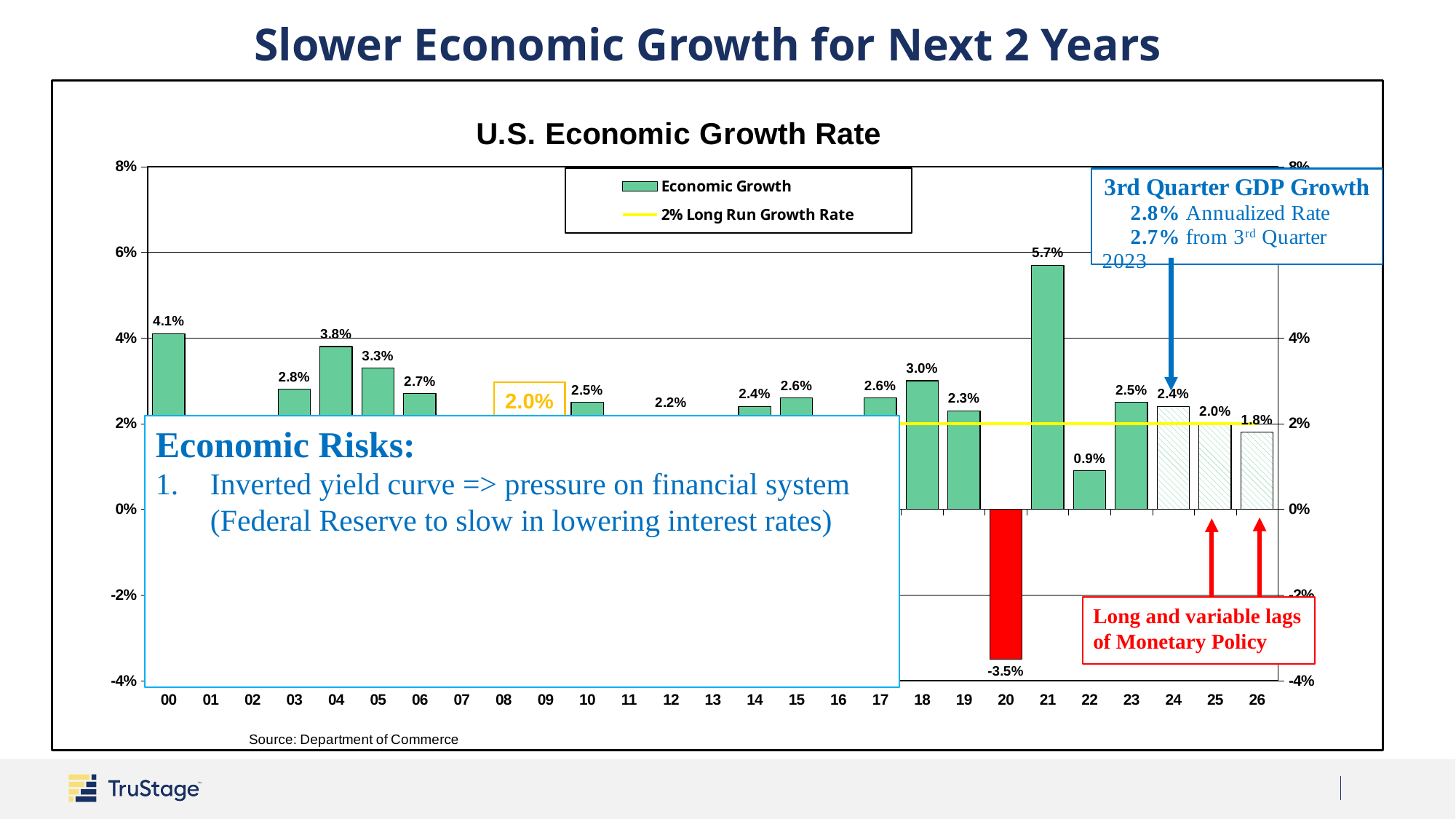
What is the economic growth rate shown for 26? 1.8% How many years are shown on the x axis of the chart? 27 What is the difference between the growth rates for 24 and 26? 0.6 percentage points Which year has the larger growth rate, 04 or 05? 04 What is the U.S. economic growth rate shown for 21? 5.7% What is the economic growth rate shown for 20? -3.5% Do the growth rates rise or fall from 24 to 26? Fall How many series does the chart legend list? 2 Is the growth rate for 22 greater or less than 2%? less Which year has the highest economic growth rate on the chart? 21 What is the economic growth rate shown for 00? 4.1% What kind of chart is used to show the U.S. Economic Growth Rate? Combination bar and line chart